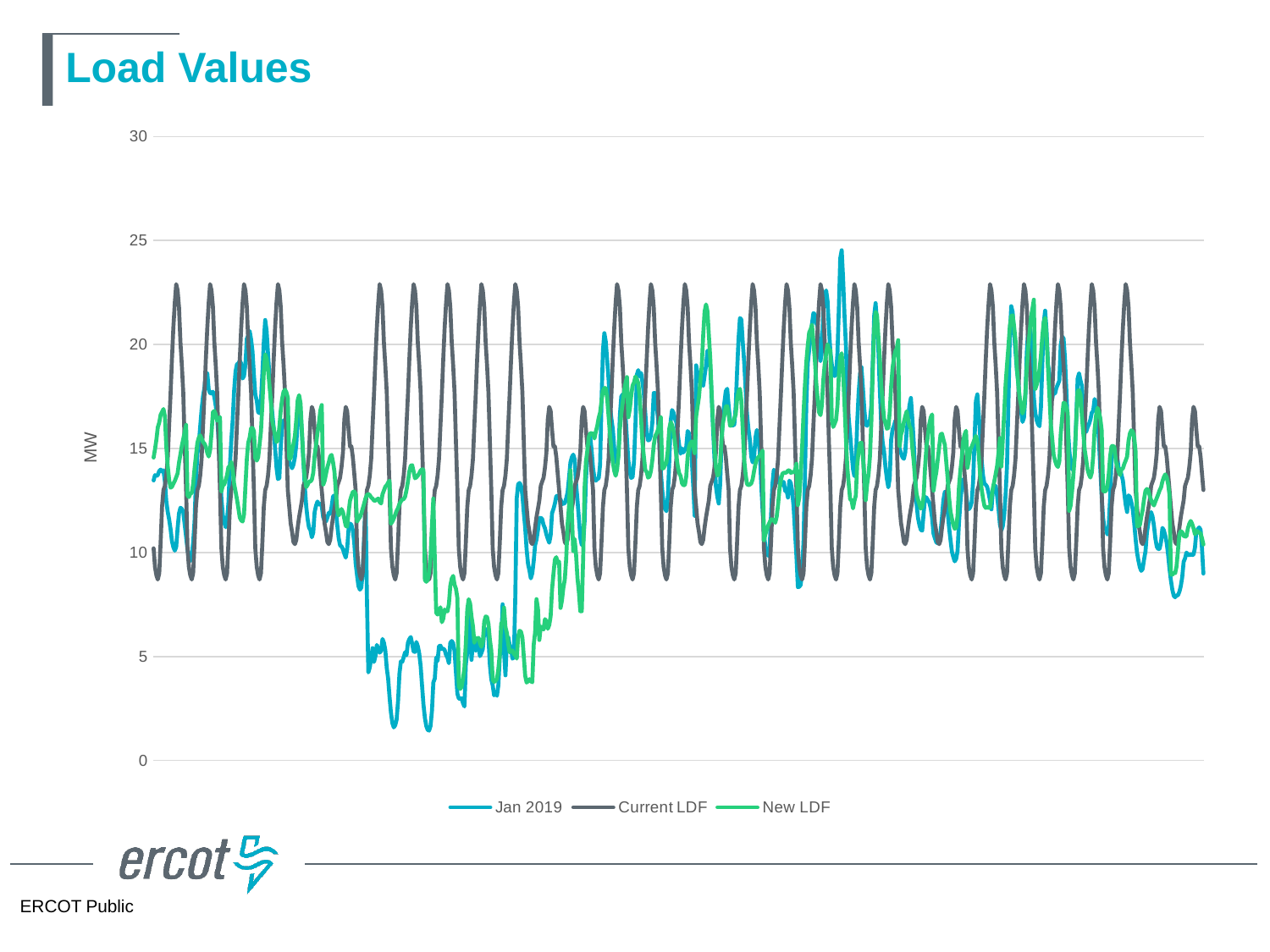
What kind of chart is shown on the slide? line chart What unit is shown on the vertical axis? MW Which series reaches the lowest value on the chart? Jan 2019 Is the lowest value of the Current LDF series greater or less than 5? greater Is the lowest value of the Jan 2019 series greater or less than 5? less How many series does the legend list? 3 What is the title of the chart? Load Values Is the highest value of the Current LDF series greater or less than 20? greater Which series reaches the highest value on the chart? Jan 2019